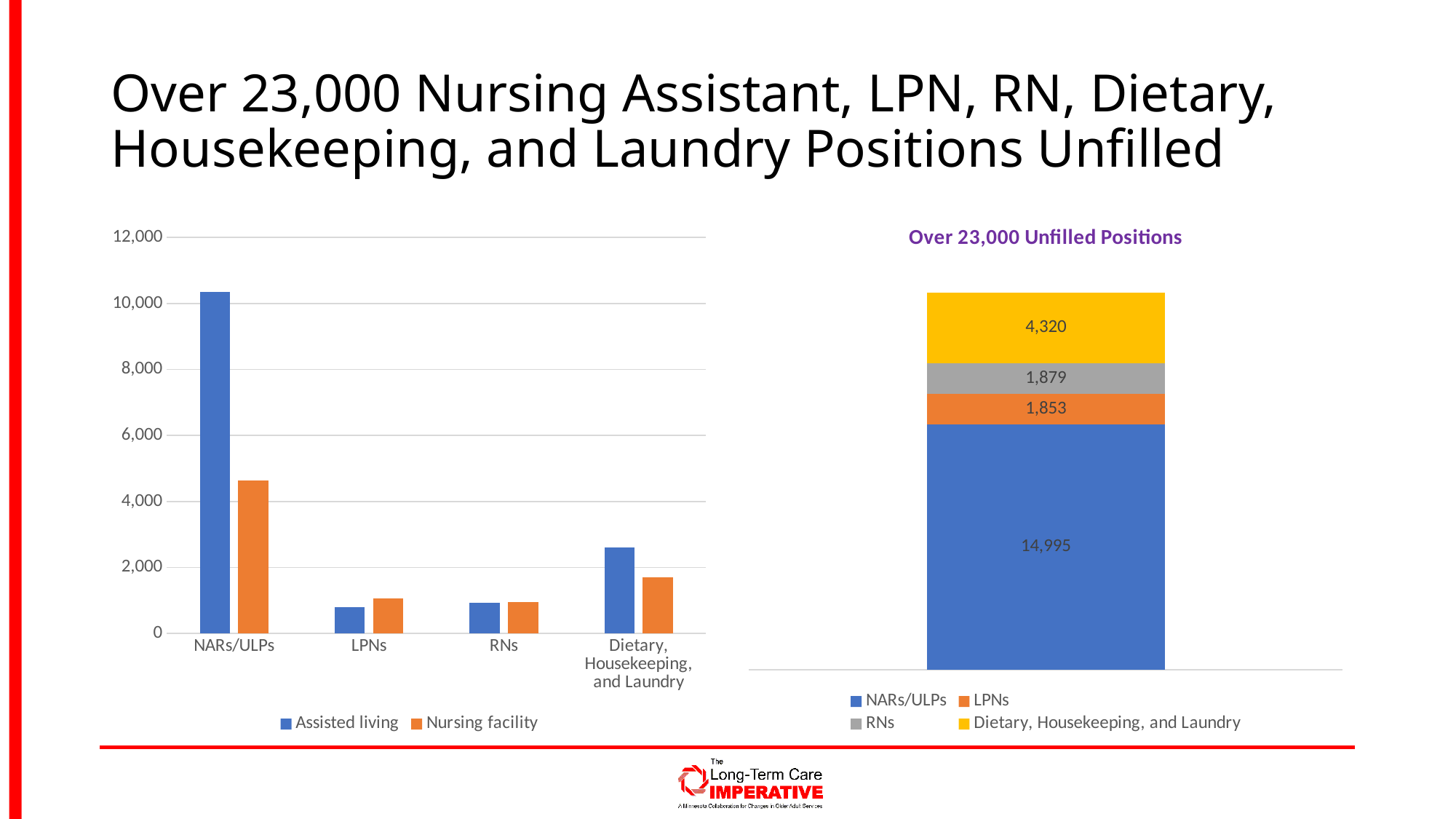
In the right chart titled 'Over 23,000 Unfilled Positions', how many unfilled NARs/ULPs positions are shown? 14,995 What kind of chart is the left chart on the slide? Bar chart In the left chart, is the Assisted living value for NARs/ULPs greater or less than 10,000? greater In the right chart titled 'Over 23,000 Unfilled Positions', what is the value for LPNs? 1,853 How many categories are shown on the x axis of the left chart? 4 How many series does the legend of the right chart titled 'Over 23,000 Unfilled Positions' list? 4 How many series does the legend of the left chart list? 2 In the right chart titled 'Over 23,000 Unfilled Positions', what is the total of the stacked bar? 23,047 In the left chart, which category has the highest Assisted living value? NARs/ULPs In the right chart titled 'Over 23,000 Unfilled Positions', what is the difference between the Dietary, Housekeeping, and Laundry value and the RNs value? 2,441 In the right chart titled 'Over 23,000 Unfilled Positions', which segment has the smallest value? LPNs In the right chart titled 'Over 23,000 Unfilled Positions', what is the value for Dietary, Housekeeping, and Laundry? 4,320